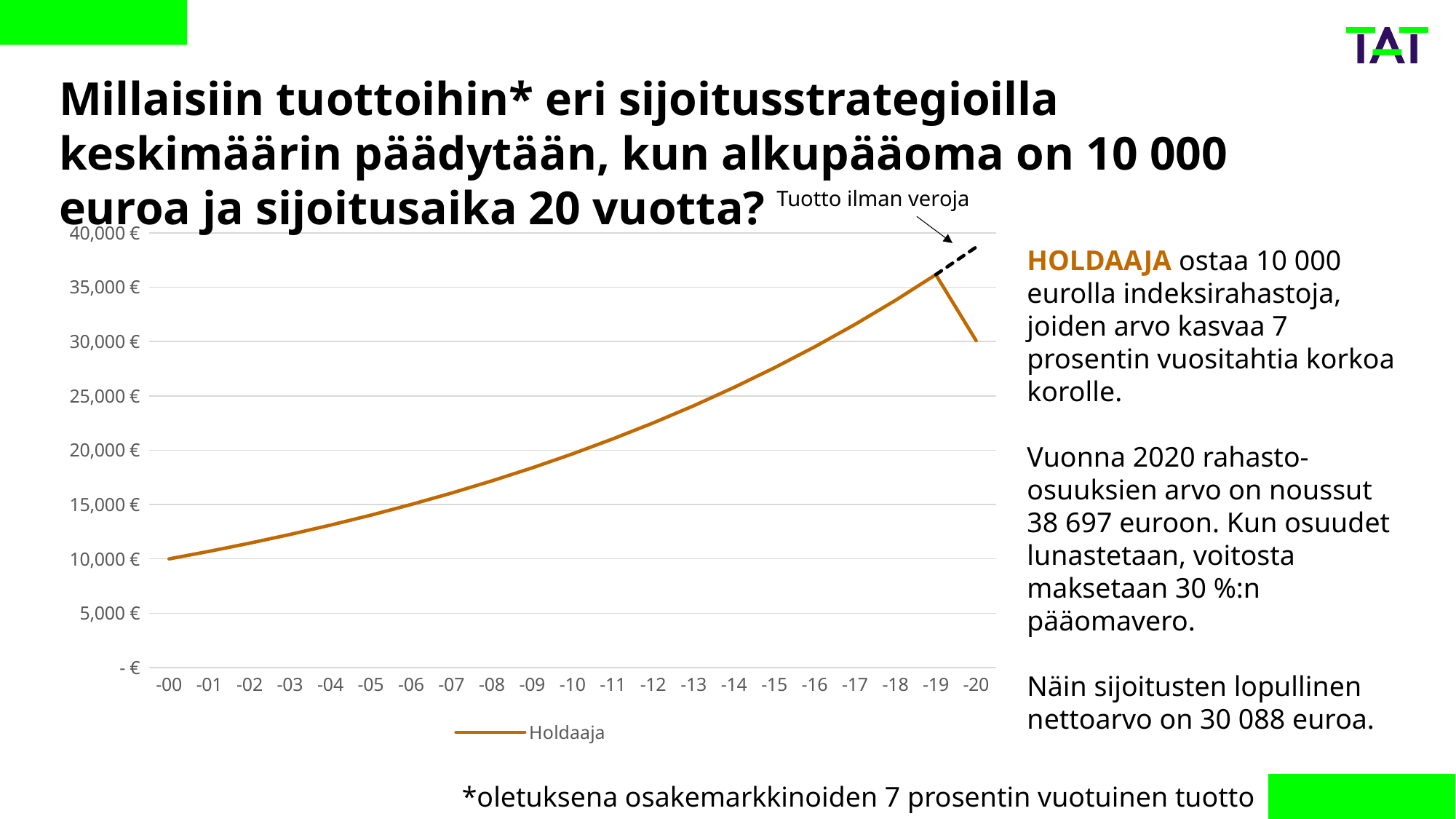
What label is attached to the dashed line at the end of the chart? Tuotto ilman veroja How many series does the legend list? 1 At which x-axis label does the Holdaaja line reach its highest value? -19 What is the name of the series shown in the legend? Holdaaja Which is larger, the Holdaaja value at -19 or at -20? -19 At which x-axis label is the Holdaaja line at its lowest value? -00 Is the value of the Holdaaja line at -08 greater or less than 15,000 €? greater What is the value of the Holdaaja line at -00? 10,000 € Is the value of the Holdaaja line at -15 greater or less than 25,000 €? greater Is the value of the Holdaaja line at -05 greater or less than 15,000 €? less How many points are plotted along the x axis (from -00 to -20)? 21 What kind of chart is shown on the slide? line chart